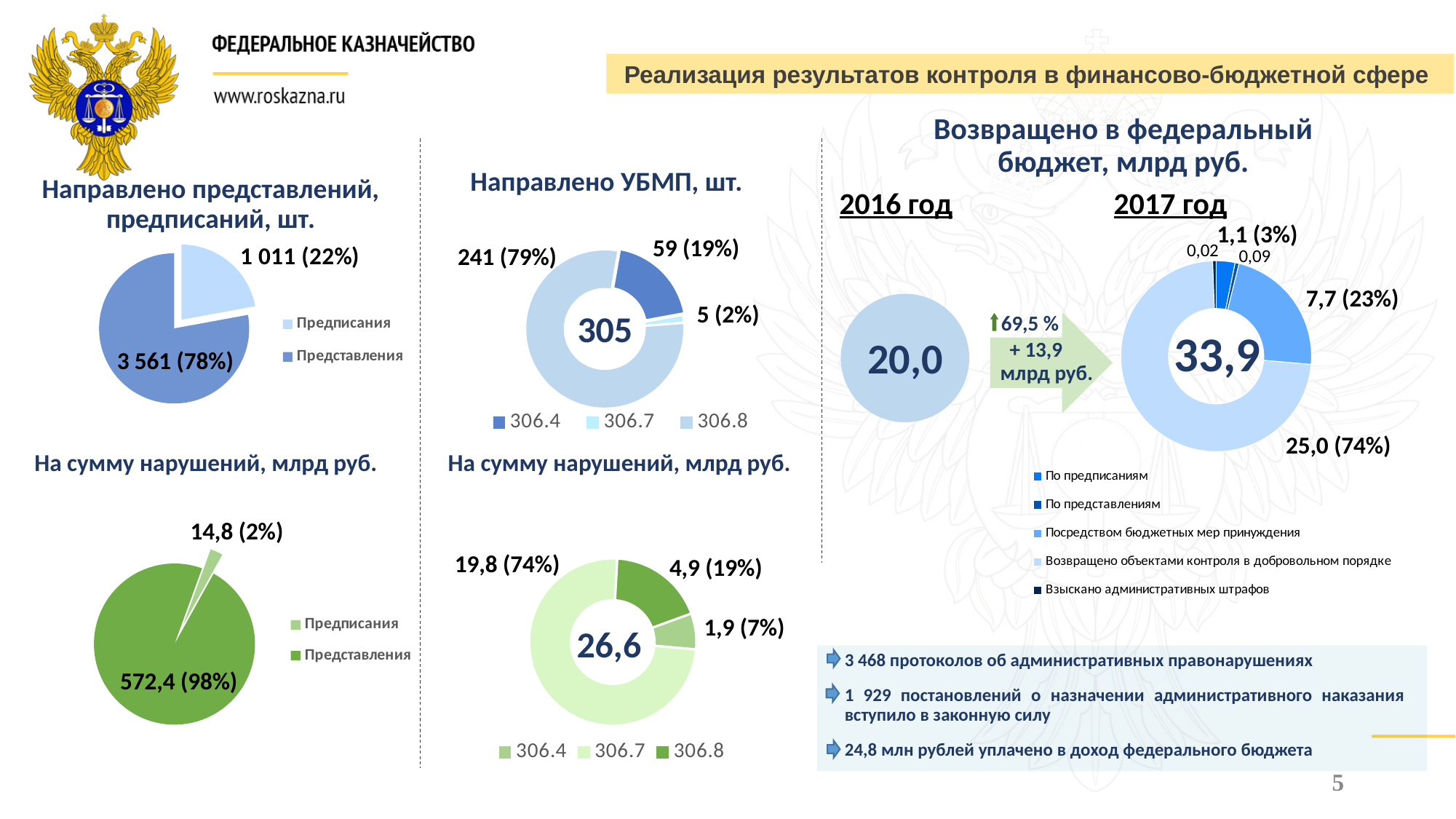
In the left-hand pie chart 'На сумму нарушений, млрд руб.', which category is the largest? Представления In the donut chart 'Направлено УБМП, шт.', what is the value for 306.8? 241 (79%) In the donut chart 'Направлено УБМП, шт.', which category is the smallest? 306.7 In the left-hand pie chart 'На сумму нарушений, млрд руб.', what is the value for Предписания? 14,8 (2%) In the pie chart 'Направлено представлений, предписаний, шт.', what share of the pie does Предписания take? 22% In the chart 'Возвращено в федеральный бюджет, млрд руб.', what is the total for 2017 год? 33,9 In the middle donut chart 'На сумму нарушений, млрд руб.', what is the value for 306.4? 1,9 (7%) In the chart 'Возвращено в федеральный бюджет, млрд руб.', how many entries does the legend list? 5 In the donut chart 'Направлено УБМП, шт.', what is the total shown in the centre? 305 In the pie chart 'Направлено представлений, предписаний, шт.', what is the value for Представления? 3 561 (78%) In the middle donut chart 'На сумму нарушений, млрд руб.', which is larger, 306.7 or 306.8? 306.7 In the middle donut chart 'На сумму нарушений, млрд руб.', how many categories does the legend list? 3